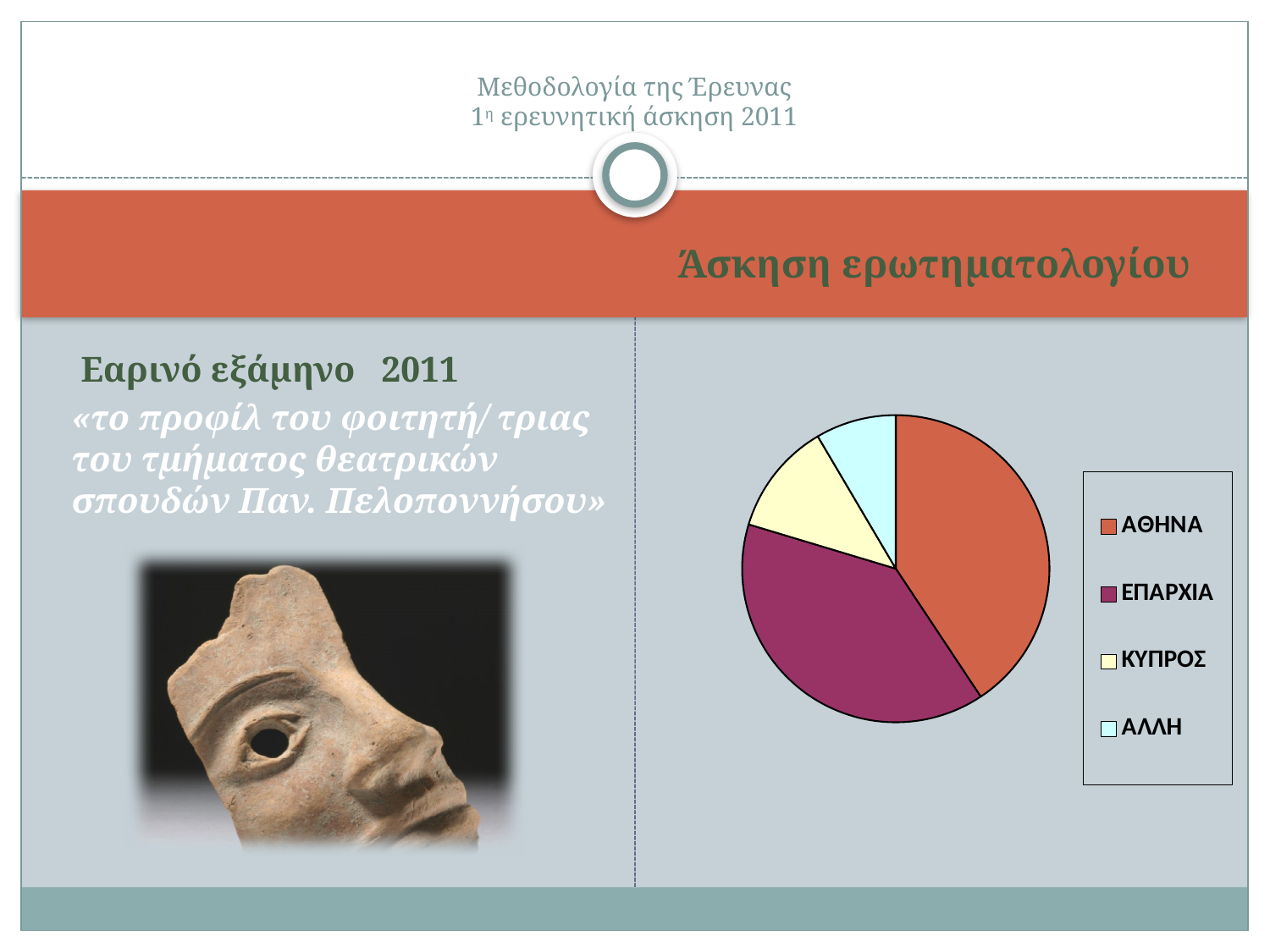
Which slice is larger, ΑΘΗΝΑ or ΕΠΑΡΧΙΑ? ΑΘΗΝΑ What colour is the ΕΠΑΡΧΙΑ slice in the pie chart? purple Which category has the largest slice of the pie chart? ΑΘΗΝΑ Which category has the smallest slice of the pie chart? ΑΛΛΗ How many slices does the pie chart have? 4 Which slice is larger, ΚΥΠΡΟΣ or ΑΛΛΗ? ΚΥΠΡΟΣ Which category is shown in orange in the pie chart? ΑΘΗΝΑ What kind of chart is shown on the slide? pie chart Which slice is larger, ΕΠΑΡΧΙΑ or ΚΥΠΡΟΣ? ΕΠΑΡΧΙΑ How many entries does the legend of the pie chart list? 4